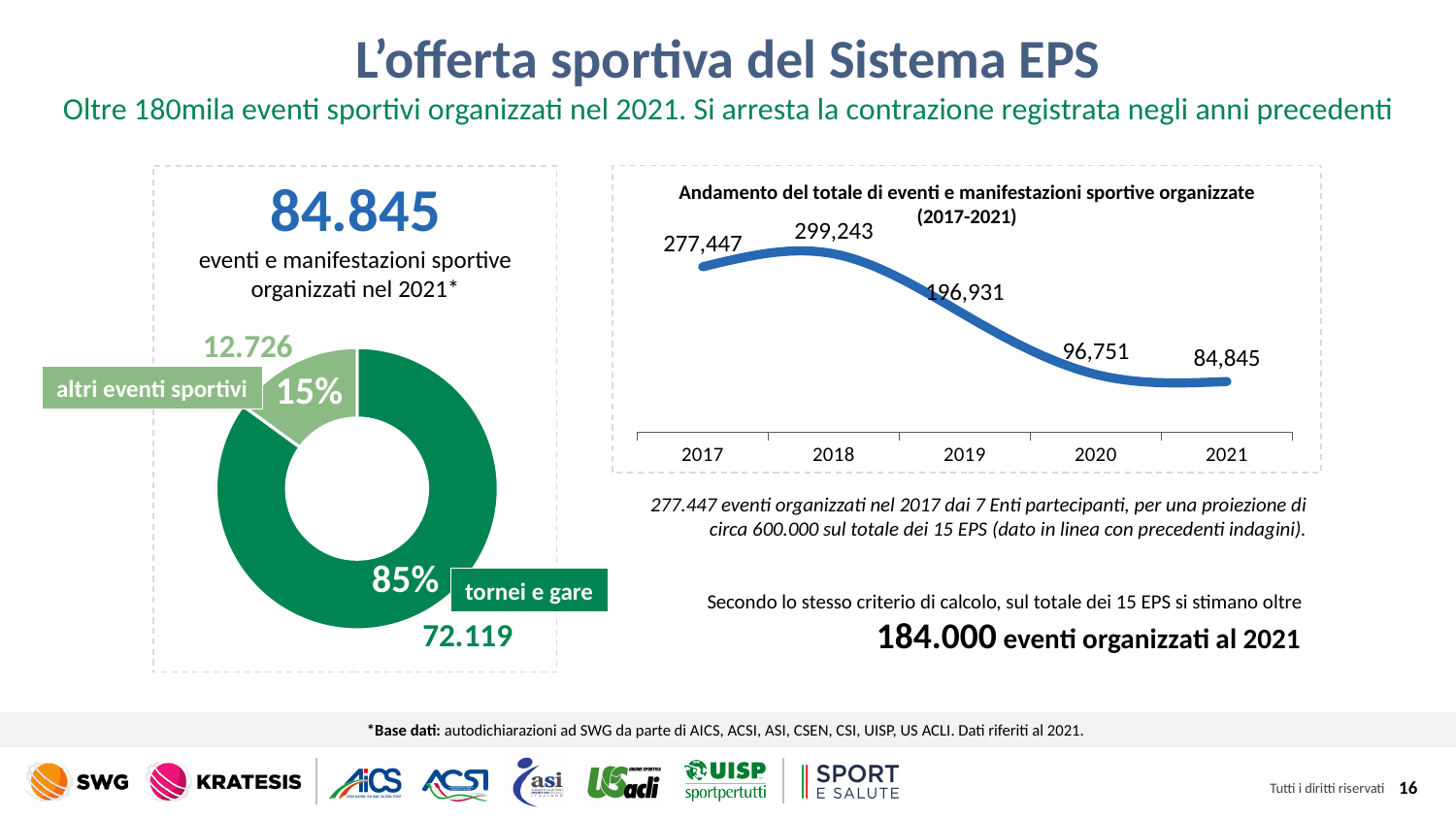
In the line chart on the right, how many years are plotted on the x axis? 5 In the line chart on the right, what is the value for 2020? 96,751 In the line chart on the right, which year has the lowest value? 2021 In the donut chart on the left, what share of the total is 'tornei e gare'? 85% In the line chart on the right, which is larger, the value for 2019 or the value for 2020? 2019 In the line chart on the right, which year has the highest value? 2018 In the donut chart on the left, what is the value for 'altri eventi sportivi'? 12.726 In the line chart on the right, do the values rise or fall from 2018 to 2021? Fall In the line chart on the right, what is the difference between the 2017 value and the 2021 value? 192,602 What kind of chart is the chart on the right of the slide? Line chart In the line chart 'Andamento del totale di eventi e manifestazioni sportive organizzate (2017-2021)', what is the value for 2018? 299,243 In the donut chart on the left, which category is larger, 'tornei e gare' or 'altri eventi sportivi'? tornei e gare